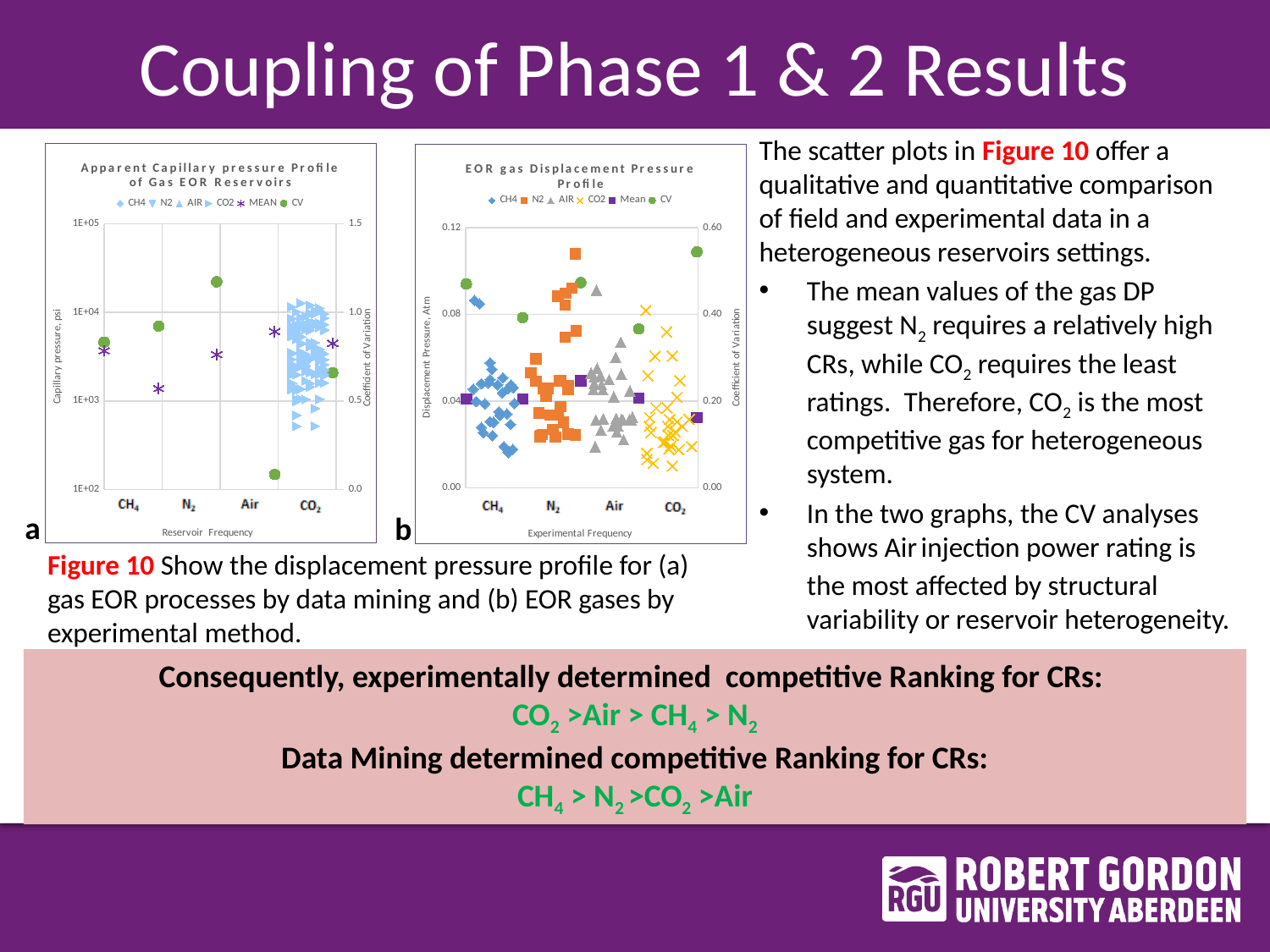
In the left chart (Apparent Capillary pressure Profile of Gas EOR Reservoirs), is the CV value for Air greater or less than 1.0? greater In the left chart (Apparent Capillary pressure Profile of Gas EOR Reservoirs), which gas has the highest CV value? Air How many series does the legend of the right chart (EOR gas Displacement Pressure Profile) list? 6 In the left chart (Apparent Capillary pressure Profile of Gas EOR Reservoirs), which gas has the lowest MEAN capillary pressure? N2 In the left chart (Apparent Capillary pressure Profile of Gas EOR Reservoirs), is the CV value for CO2 greater or less than 0.5? greater How many series does the legend of the left chart (Apparent Capillary pressure Profile of Gas EOR Reservoirs) list? 6 In the left chart (Apparent Capillary pressure Profile of Gas EOR Reservoirs), how many gas categories are shown on the x axis? 4 In the right chart (EOR gas Displacement Pressure Profile), is the CV value for CO2 greater or less than 0.40? greater In the right chart (EOR gas Displacement Pressure Profile), which gas has the highest CV value? CO2 What is the x-axis title of the right chart (EOR gas Displacement Pressure Profile)? Experimental Frequency What kind of chart is the left chart titled 'Apparent Capillary pressure Profile of Gas EOR Reservoirs'? Scatter chart